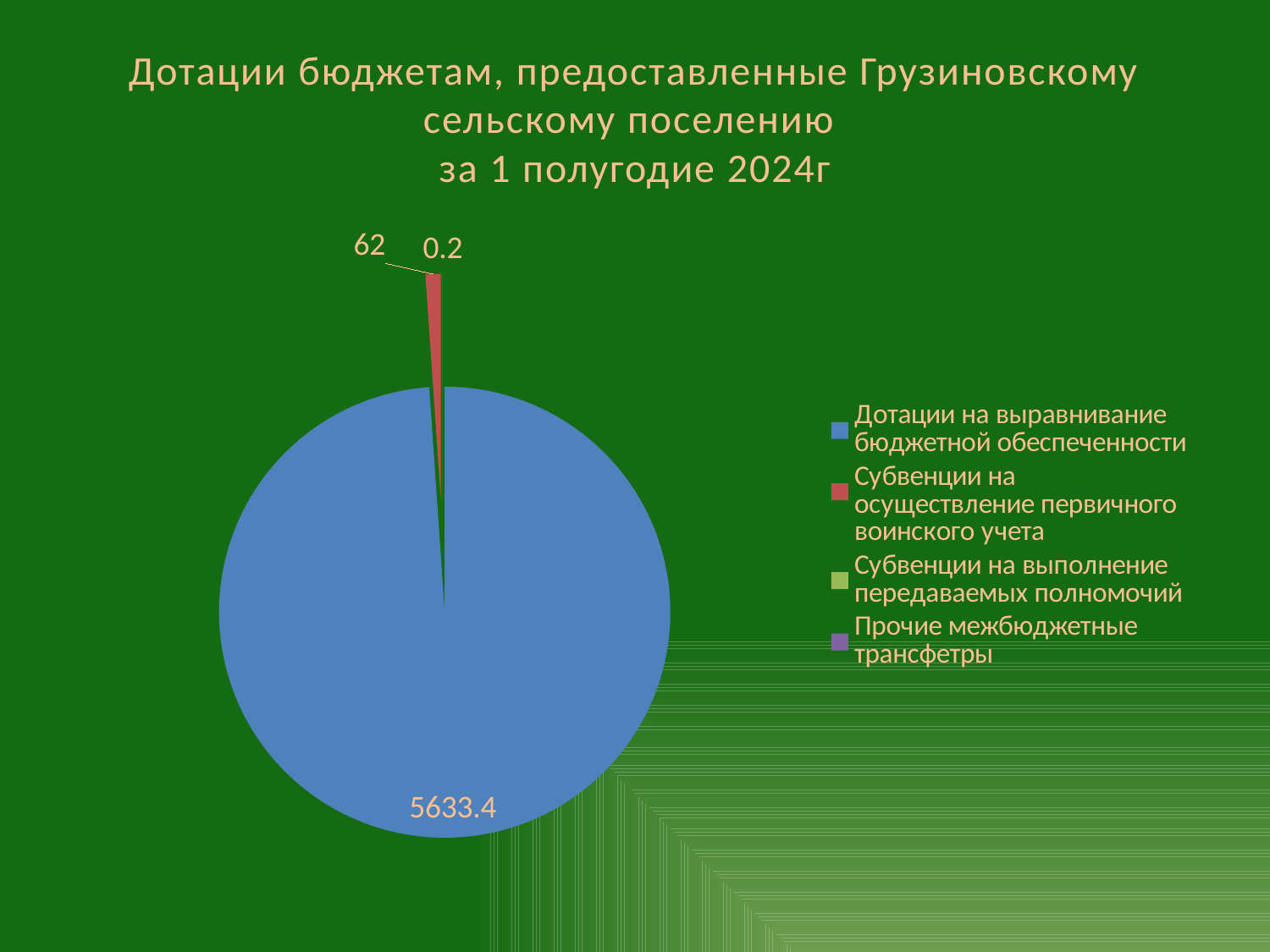
How many entries does the legend list? 4 Which is larger: Дотации на выравнивание бюджетной обеспеченности or Субвенции на осуществление первичного воинского учета? Дотации на выравнивание бюджетной обеспеченности What is the value shown for Субвенции на осуществление первичного воинского учета? 62 What period does the chart title say the data covers? 1 полугодие 2024г What is the value shown for Дотации на выравнивание бюджетной обеспеченности? 5633.4 What colour is the slice for Субвенции на осуществление первичного воинского учета? red What kind of chart is shown on the slide? pie chart Which category has the largest slice of the pie? Дотации на выравнивание бюджетной обеспеченности What is the smallest data label printed on the pie chart? 0.2 What is the difference between the value for Дотации на выравнивание бюджетной обеспеченности and the value for Субвенции на осуществление первичного воинского учета? 5571.4